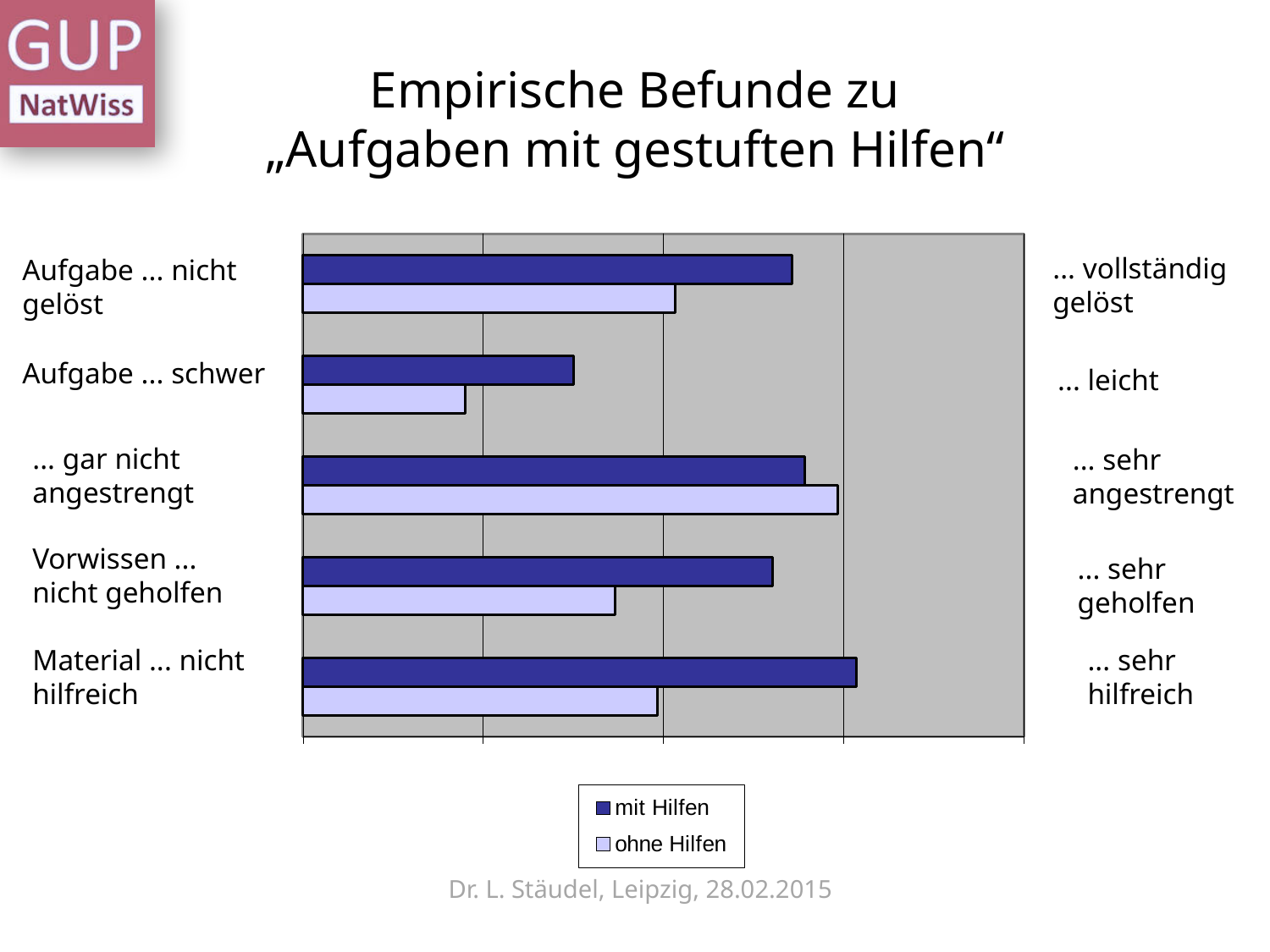
What are the two series named in the legend? mit Hilfen, ohne Hilfen In the 'mit Hilfen' series, which category has the shortest bar? Aufgabe ... schwer / ... leicht How many series does the legend list? 2 What kind of chart is shown on the slide? bar chart How many bars are plotted in total in the chart? 10 For the category 'Material ... nicht hilfreich / ... sehr hilfreich', which series has the longer bar, 'mit Hilfen' or 'ohne Hilfen'? mit Hilfen In the 'ohne Hilfen' series, which category has the longest bar? ... gar nicht angestrengt / ... sehr angestrengt How many categories (pairs of bars) are plotted in the chart? 5 In the 'mit Hilfen' series, which category has the longest bar? Material ... nicht hilfreich / ... sehr hilfreich For the category 'Vorwissen ... nicht geholfen / ... sehr geholfen', which series has the longer bar, 'mit Hilfen' or 'ohne Hilfen'? mit Hilfen For the category 'Aufgabe ... schwer / ... leicht', which series has the longer bar, 'mit Hilfen' or 'ohne Hilfen'? mit Hilfen